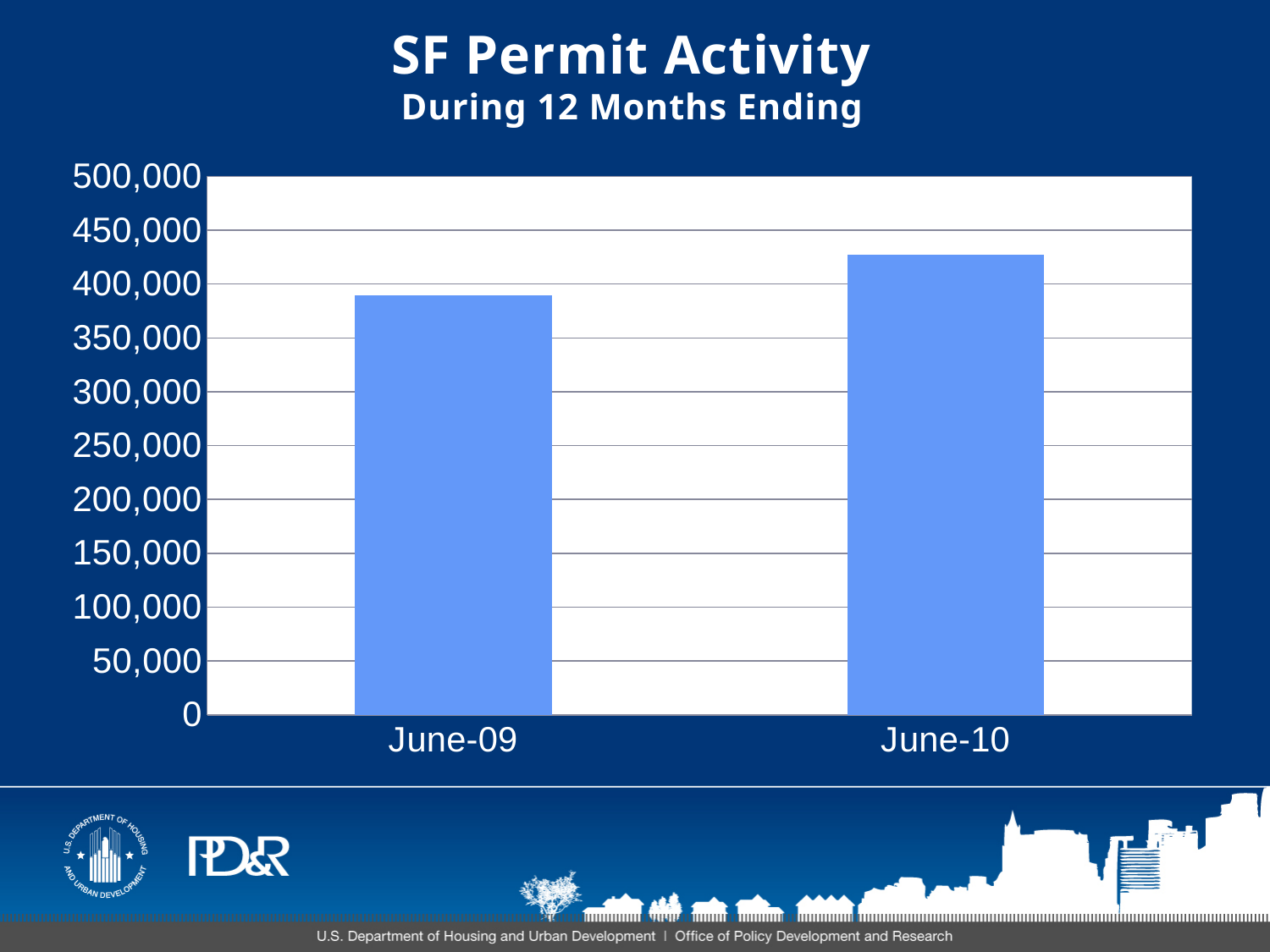
Which period has the lower SF permit activity? June-09 What is the subtitle shown under the chart title? During 12 Months Ending How many bars (categories) are plotted in the chart? 2 Do the values rise or fall from June-09 to June-10? rise Is the value for June-09 greater or less than 350,000? greater Is the value for June-10 greater or less than 400,000? greater Is the value for June-09 greater or less than 400,000? less What is the title of the chart? SF Permit Activity Which period has the higher SF permit activity, June-09 or June-10? June-10 What kind of chart is shown on the slide? bar chart Is the value for June-10 larger or smaller than the value for June-09? larger